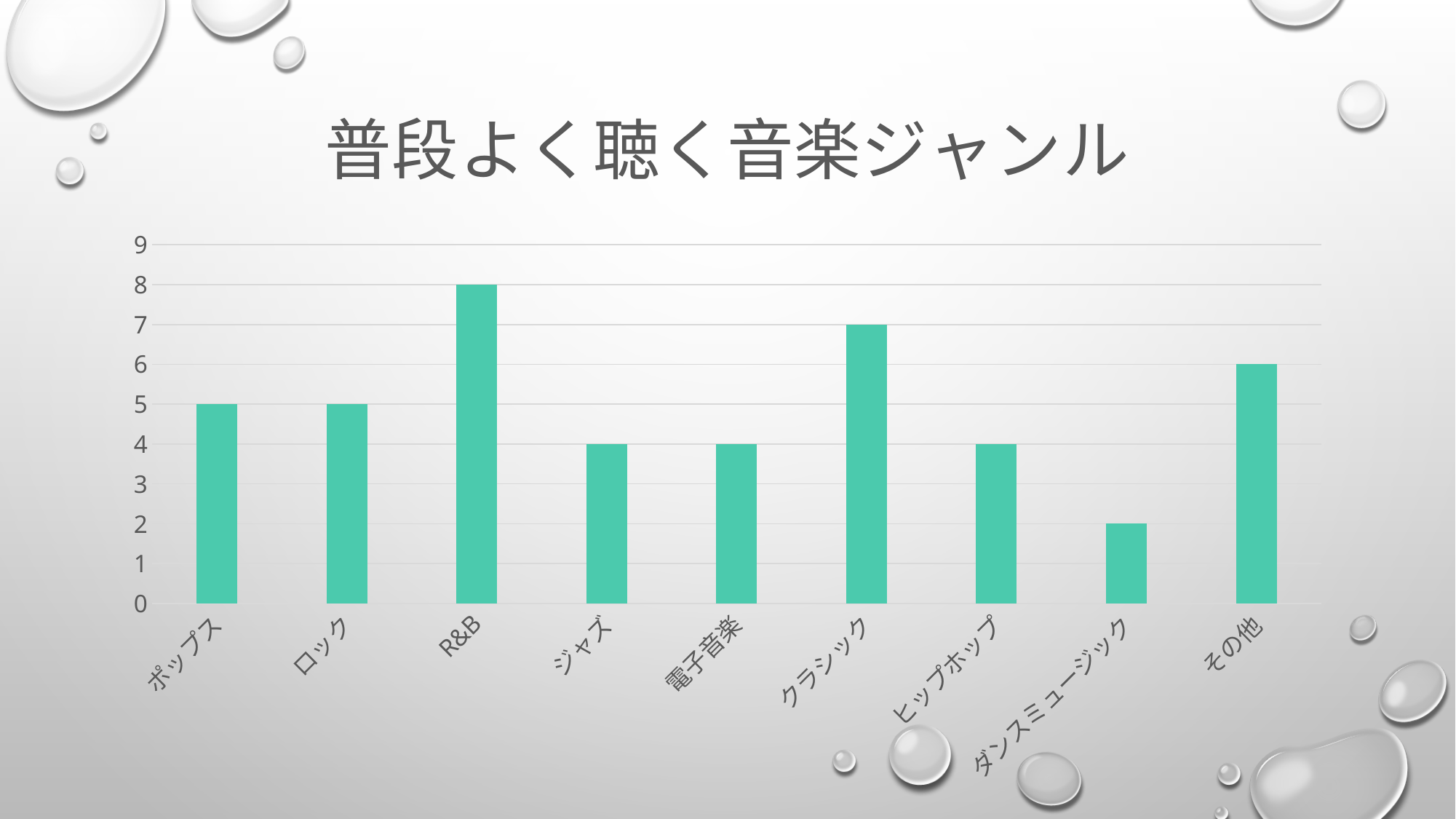
How many categories are shown on the x axis? 9 What is the value for R&B? 8 Which category has the highest value? R&B What is the value for クラシック? 7 What is the value for ダンスミュージック? 2 Which category has the lowest value? ダンスミュージック What is the title of the chart? 普段よく聴く音楽ジャンル Is the value for ポップス greater or less than 3? greater What type of chart is shown on the slide? Bar chart Which is larger, the value for クラシック or the value for ヒップホップ? クラシック What is the value for その他? 6 What is the difference between the values for R&B and ジャズ? 4